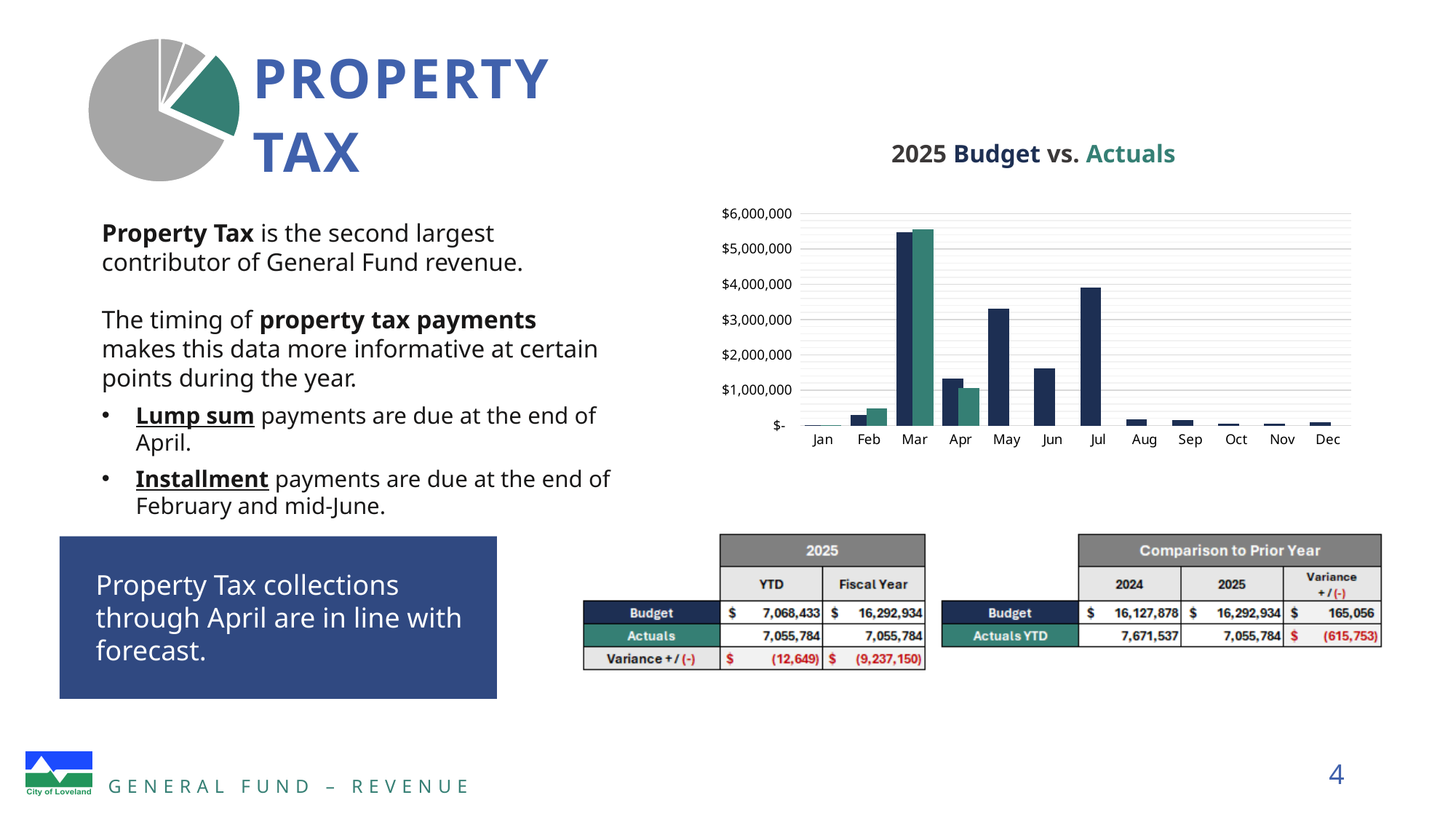
In the '2025 Budget vs. Actuals' chart, is the Budget value for Jul greater or less than $3,000,000? greater In the '2025 Budget vs. Actuals' chart, which is larger for Apr: the Budget bar or the Actuals bar? Budget In the '2025 Budget vs. Actuals' chart, is the Budget value for Jun greater or less than $2,000,000? less In the '2025 Budget vs. Actuals' chart, is the Budget value for May greater or less than $4,000,000? less What is the title of the bar chart on the slide? 2025 Budget vs. Actuals How many months are shown on the x axis of the '2025 Budget vs. Actuals' chart? 12 In the '2025 Budget vs. Actuals' chart, do the Budget bars rise or fall from Mar to Apr? fall In the '2025 Budget vs. Actuals' chart, which month has the larger Budget bar: May or Jul? Jul What kind of chart is the '2025 Budget vs. Actuals' chart? bar chart In the '2025 Budget vs. Actuals' chart, which is larger for Feb: the Budget bar or the Actuals bar? Actuals In the '2025 Budget vs. Actuals' chart, which month has the tallest Budget bar? Mar